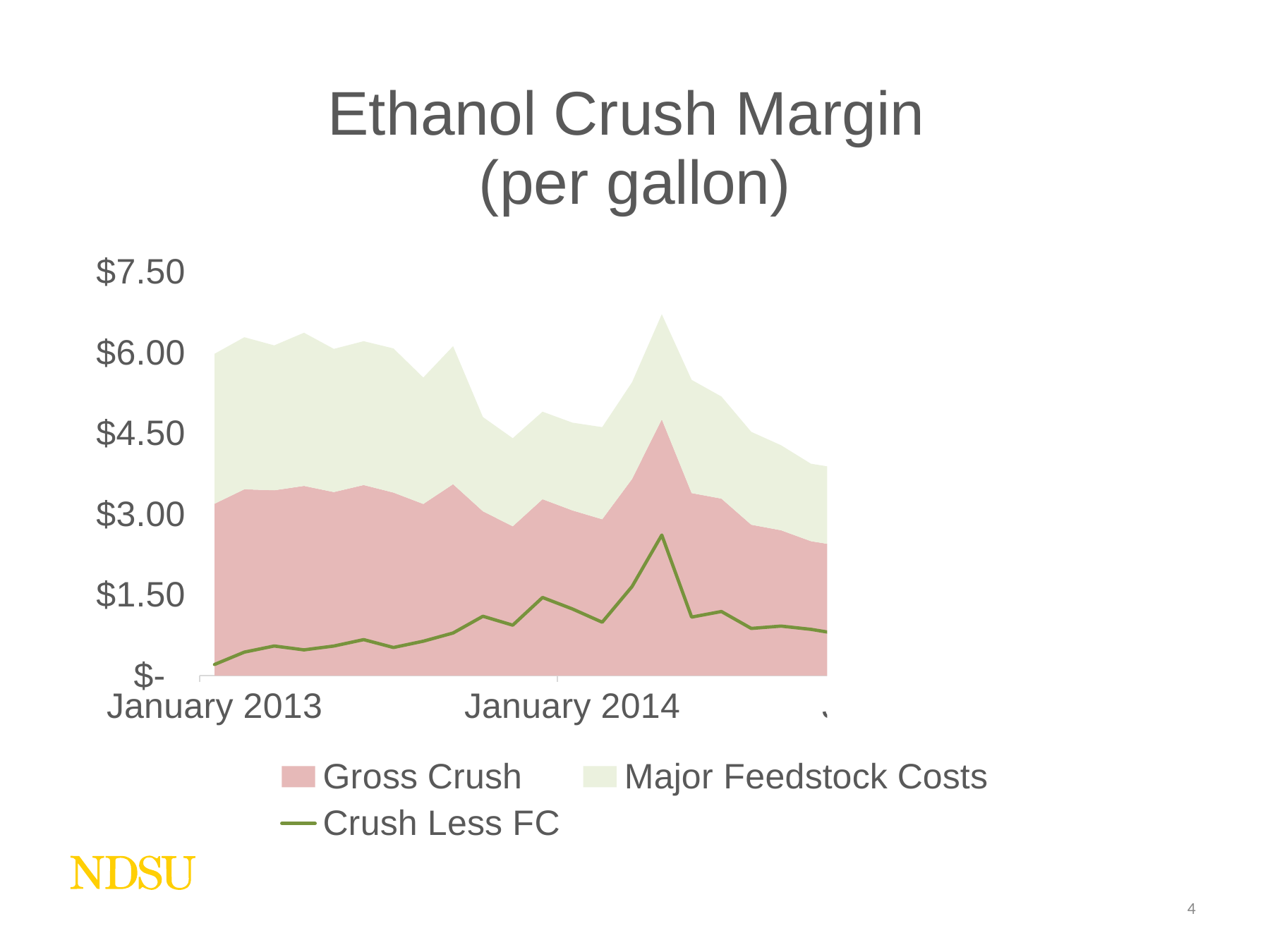
Is the Gross Crush value at January 2013 greater or less than $3.00? greater Is the top of the stacked area (Gross Crush plus Major Feedstock Costs) at January 2013 greater or less than $4.50? greater Is the peak value of the Crush Less FC line greater or less than $1.50? greater Does the Crush Less FC line reach its highest point before or after January 2014? after What kind of chart is this? Stacked area chart with a line series What is the highest value shown on the vertical axis? $7.50 How many series does the legend list? 3 Does the Crush Less FC line rise or fall from January 2013 to January 2014? rise What is the title of the chart? Ethanol Crush Margin (per gallon) Which series is drawn as a line rather than a filled area? Crush Less FC